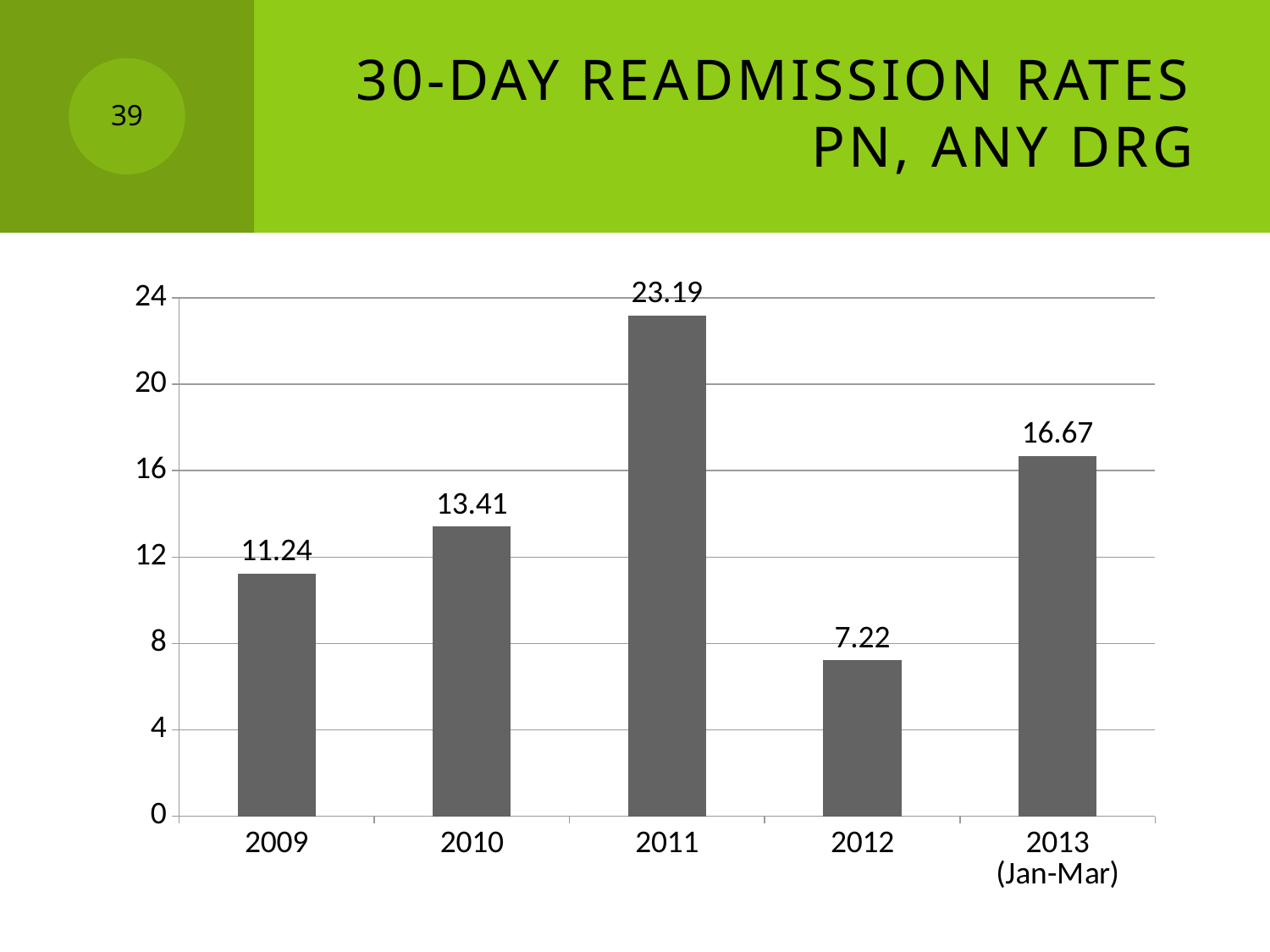
What is the difference between the readmission rates for 2011 and 2012? 15.97 Is the value for 2012 greater or less than 8? less Does the readmission rate rise or fall from 2011 to 2012? fall Which year has the highest 30-day readmission rate? 2011 How many years (categories) are shown on the chart? 5 What is the 30-day readmission rate for 2013 (Jan-Mar)? 16.67 What is the 30-day readmission rate for 2011? 23.19 What kind of chart is shown on the slide? bar chart What is the 30-day readmission rate for 2009? 11.24 What is the difference between the readmission rates for 2010 and 2009? 2.17 Which year has the lowest 30-day readmission rate? 2012 Which is larger, the readmission rate for 2010 or for 2013 (Jan-Mar)? 2013 (Jan-Mar)